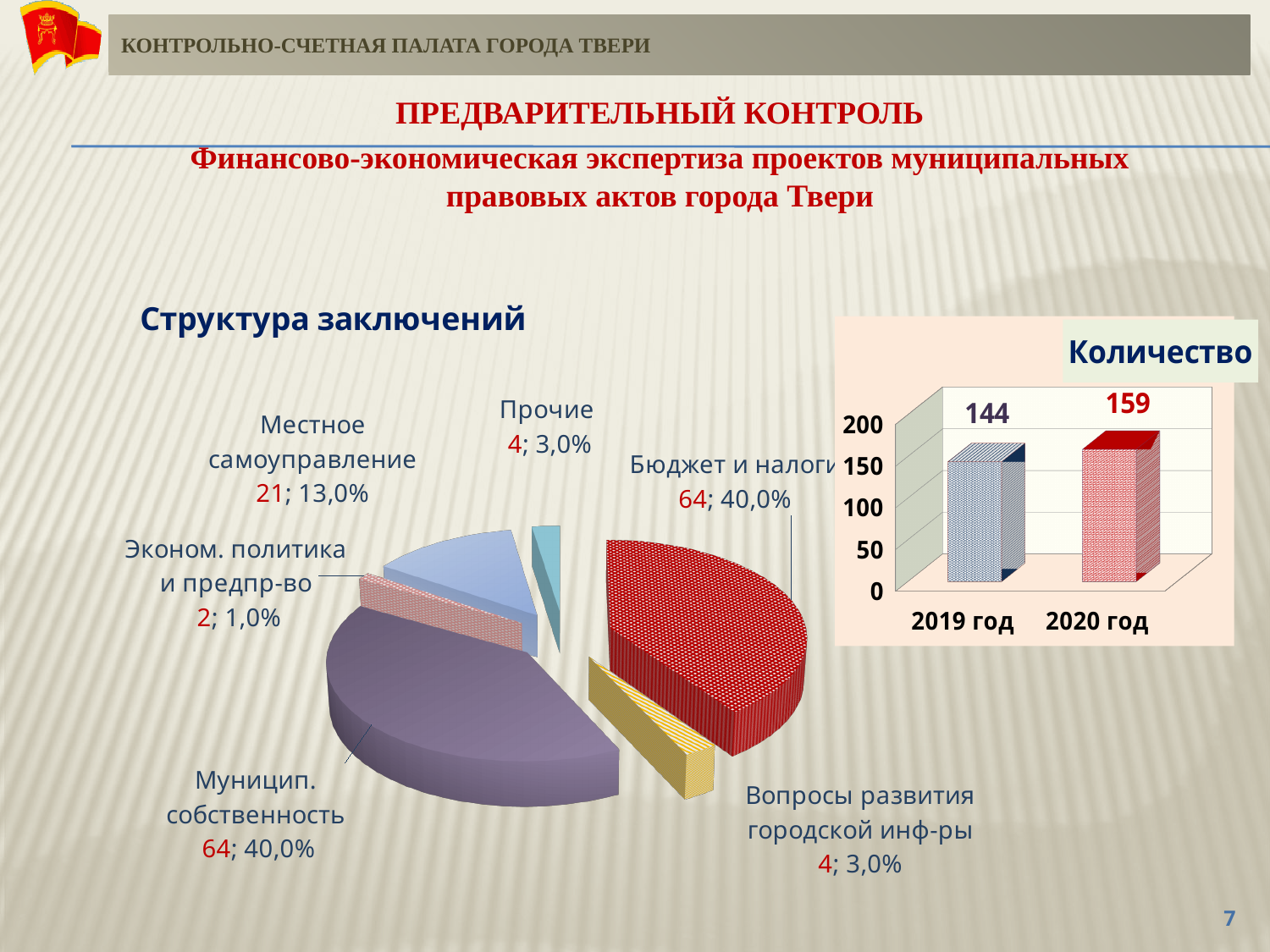
In the 'Количество' bar chart, by how much does the value for 2020 год exceed the value for 2019 год? 15 What kind of chart is the 'Количество' chart? bar chart In the 'Структура заключений' pie chart, what share does 'Бюджет и налоги' have? 40,0% In the 'Количество' bar chart, do the values rise or fall from 2019 год to 2020 год? rise In the 'Структура заключений' pie chart, which is larger: 'Местное самоуправление' or 'Прочие'? Местное самоуправление In the 'Количество' bar chart, what is the value for 2019 год? 144 In the 'Структура заключений' pie chart, which category has the smallest slice? Эконом. политика и предпр-во In the 'Структура заключений' pie chart, what share does 'Вопросы развития городской инф-ры' have? 3,0% In the 'Структура заключений' pie chart, how many slices are there? 6 In the 'Структура заключений' pie chart, what is the count for 'Местное самоуправление'? 21 What kind of chart is the 'Структура заключений' chart? pie chart In the 'Количество' bar chart, what is the value for 2020 год? 159